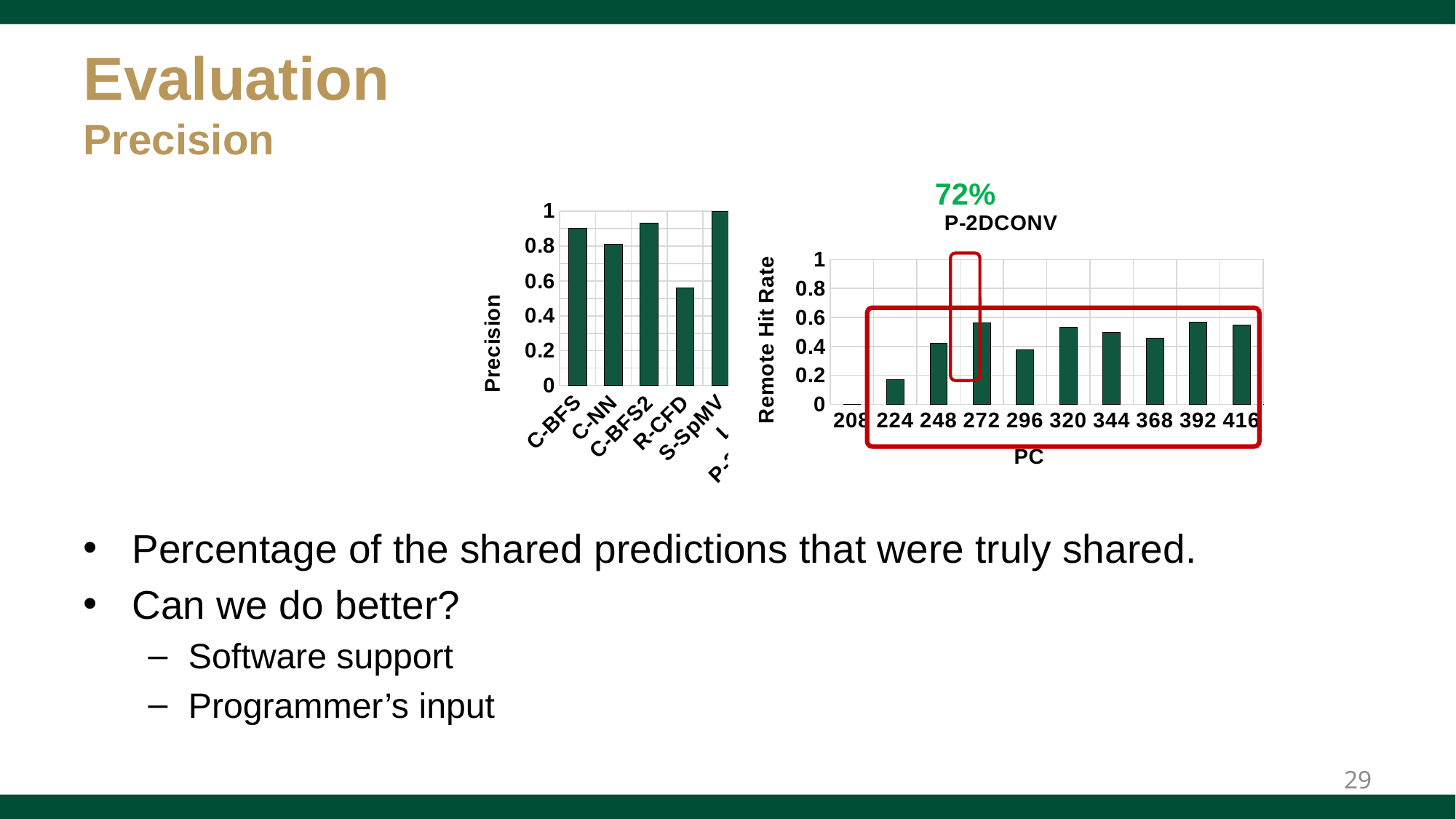
In the right chart (P-2DCONV), what is the label of the y axis? Remote Hit Rate In the right chart (P-2DCONV), is the value for PC 272 greater or less than 0.4? greater In the left chart (Precision), which category has the highest precision? S-SpMV In the right chart (P-2DCONV), is the value for PC 224 greater or less than 0.2? less In the left chart (Precision), which category has the lowest precision? R-CFD In the left chart (Precision), which is larger, the precision for C-BFS or for R-CFD? C-BFS In the right chart (P-2DCONV), which PC has the lowest remote hit rate? 208 In the left chart (Precision), is the value for R-CFD greater or less than 0.6? less In the right chart (P-2DCONV), which is larger, the remote hit rate for PC 224 or for PC 248? 248 In the left chart (Precision), what kind of chart is shown? bar chart In the right chart (P-2DCONV), how many PC values are shown on the x axis? 10